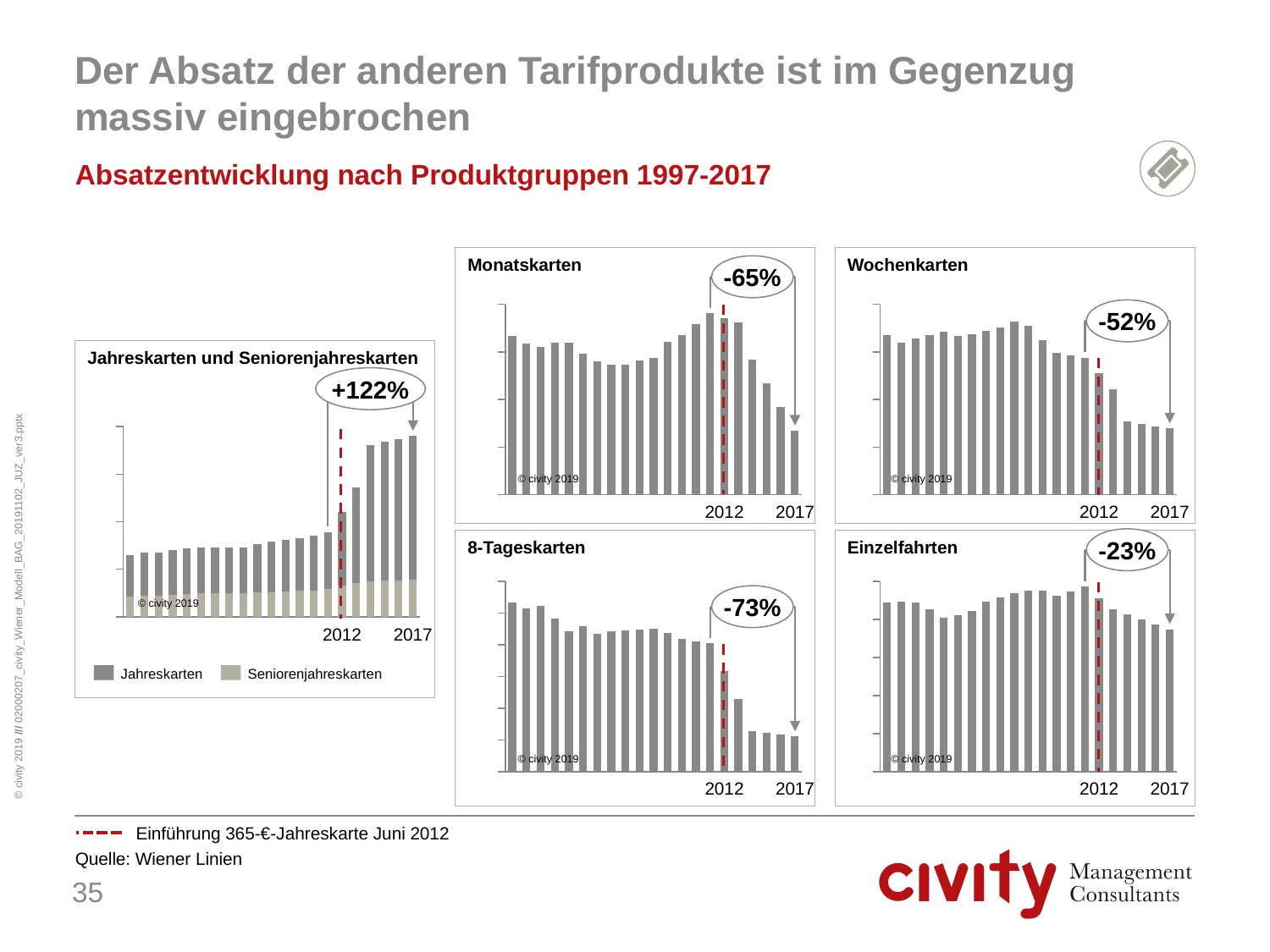
What kind of chart is the 'Monatskarten' chart? bar chart How many charts are shown on the slide? 5 How many series does the legend of the 'Jahreskarten und Seniorenjahreskarten' chart list? 2 What percentage change is annotated on the '8-Tageskarten' chart? -73% What percentage change is annotated on the 'Einzelfahrten' chart? -23% What percentage change is annotated on the 'Wochenkarten' chart? -52% In the 'Jahreskarten und Seniorenjahreskarten' chart, do the values rise or fall after 2012? rise Among the annotated percentage changes, which product group shows the smallest decline? Einzelfahrten Among the annotated percentage changes, which product group shows the largest decline? 8-Tageskarten Is the annotated decline for 'Monatskarten' larger or smaller than the decline for 'Wochenkarten'? larger What percentage change is annotated on the 'Jahreskarten und Seniorenjahreskarten' chart? +122% What percentage change is annotated on the 'Monatskarten' chart? -65%